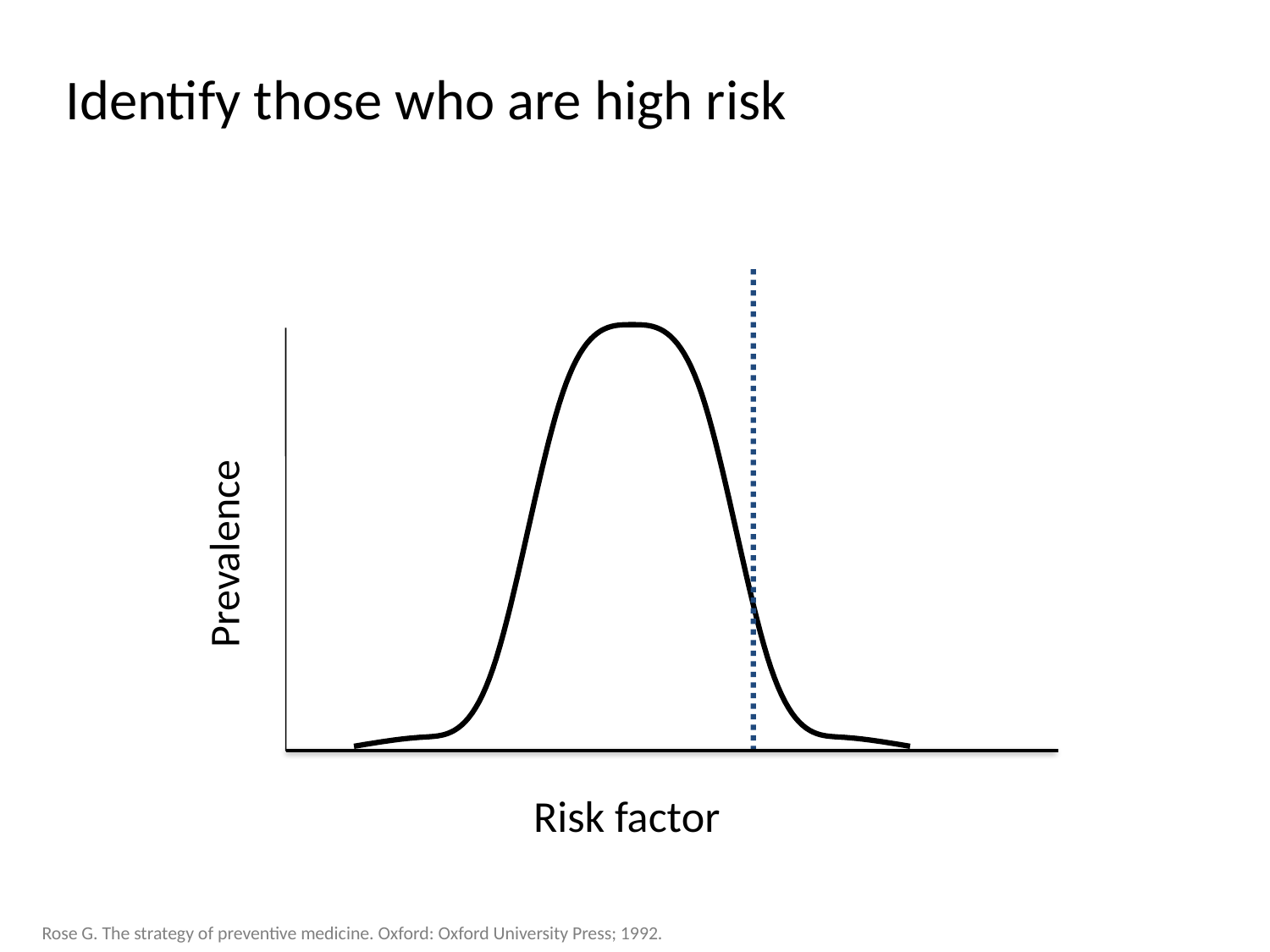
What kind of chart is shown on the slide? Line chart Is prevalence at the dotted vertical line higher or lower than at the peak of the curve? Lower What is the label of the vertical axis? Prevalence How does prevalence change as the risk factor increases along the x axis? Rises to a peak, then falls How many curves are plotted on the chart? 1 Is the dotted vertical line positioned to the left or right of the peak of the curve? Right What is the label of the horizontal axis? Risk factor